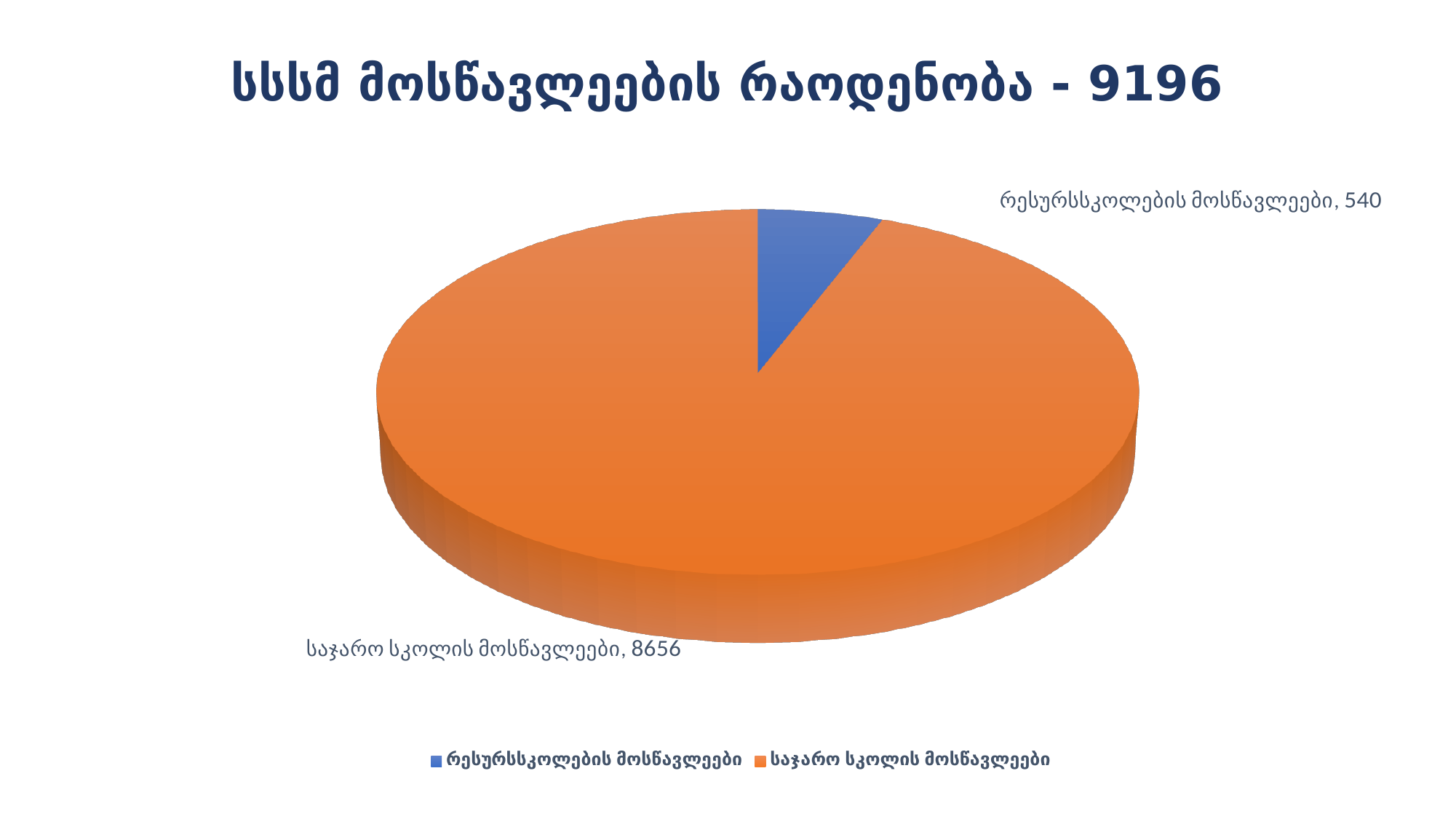
How many slices does the pie chart have? 2 Which category has the smallest slice of the pie? რესურსსკოლების მოსწავლეები What is the value for რესურსსკოლების მოსწავლეები? 540 How many entries does the legend list? 2 What colour is the slice for საჯარო სკოლის მოსწავლეები? Orange Which category has the largest slice of the pie? საჯარო სკოლის მოსწავლეები What is the total of the two slices in the pie chart? 9196 Which is larger: the value for რესურსსკოლების მოსწავლეები or the value for საჯარო სკოლის მოსწავლეები? საჯარო სკოლის მოსწავლეები What is the difference between the values for საჯარო სკოლის მოსწავლეები and რესურსსკოლების მოსწავლეები? 8116 What is the value for საჯარო სკოლის მოსწავლეები? 8656 What kind of chart is shown on the slide? Pie chart